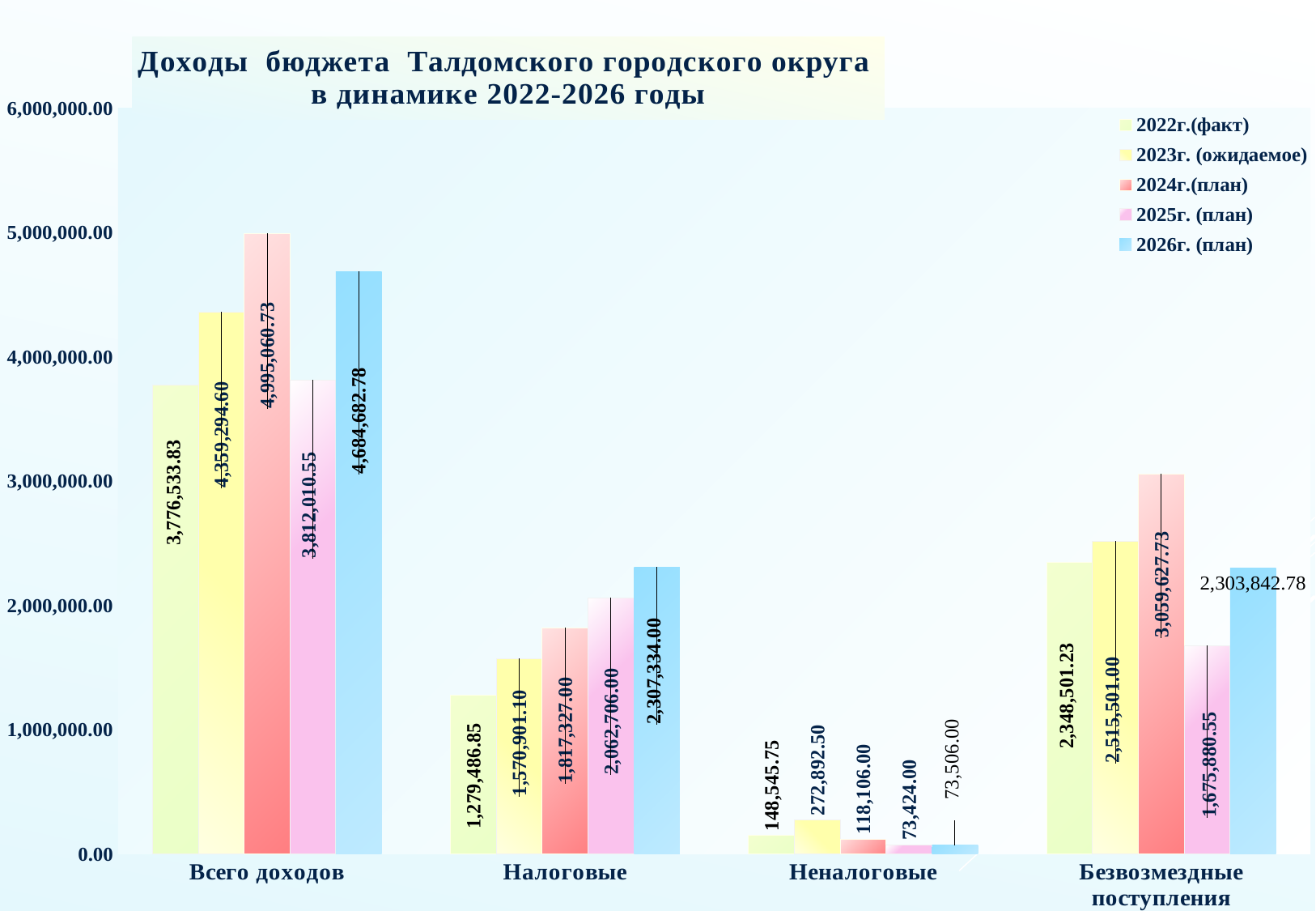
What is the value for 2022г.(факт) in the Всего доходов category? 3,776,533.83 Which is larger in 2025г. (план): Налоговые or Безвозмездные поступления? Налоговые How many categories are shown on the x axis? 4 Which year has the highest value in the Всего доходов category? 2024г.(план) How many series does the legend list? 5 Is the value for 2024г.(план) in Безвозмездные поступления greater or less than 3,000,000.00? greater What is the value for 2026г. (план) in the Налоговые category? 2,307,334.00 What is the value for 2025г. (план) in the Безвозмездные поступления category? 1,675,880.55 Which year has the lowest value in the Налоговые category? 2022г.(факт) What is the difference between the 2026г. (план) and 2022г.(факт) values in the Налоговые category? 1,027,847.15 What is the value for 2023г. (ожидаемое) in the Неналоговые category? 272,892.50 Do the values in the Налоговые category rise or fall from 2022 to 2026? rise